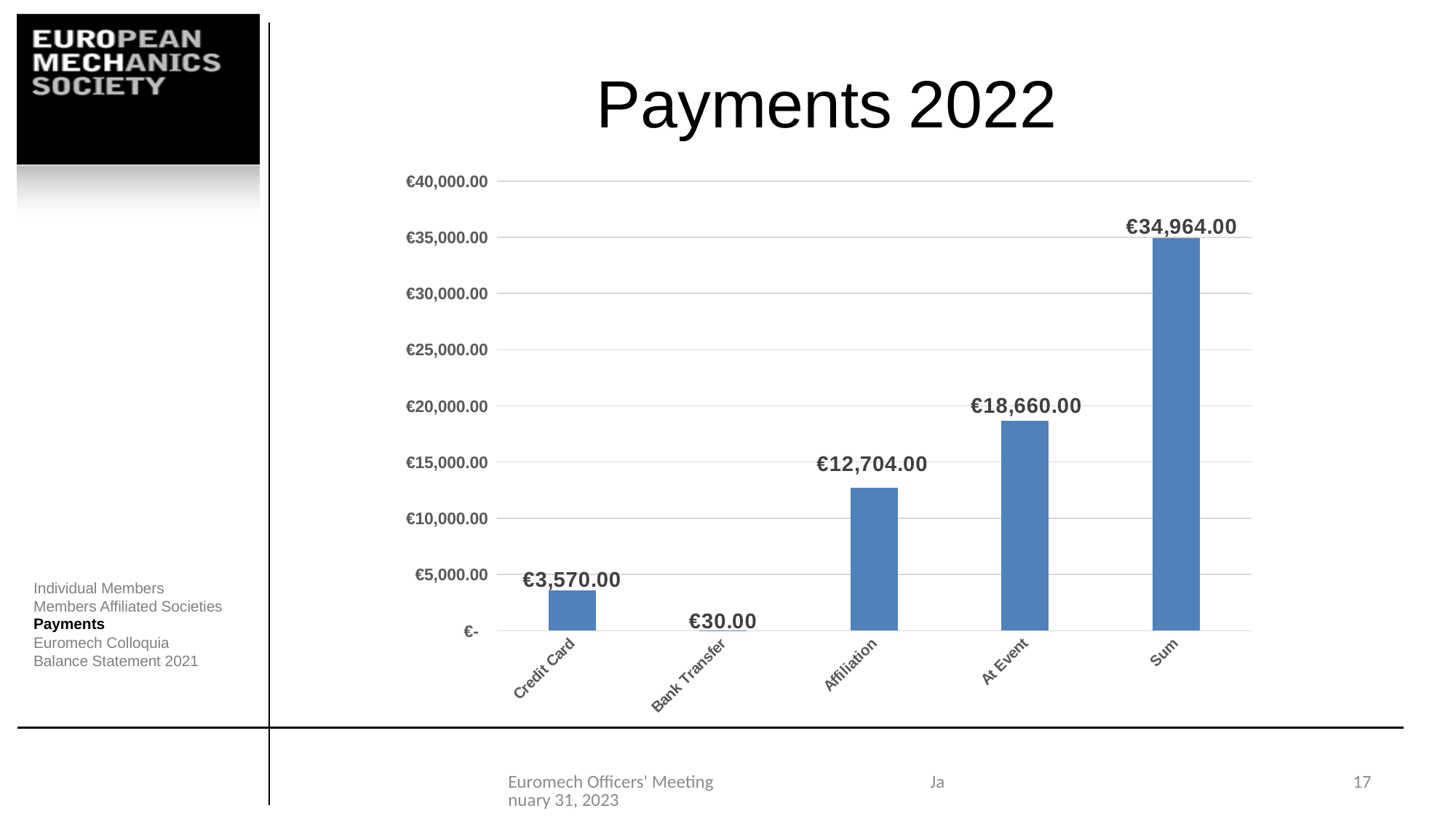
What is the value for Credit Card? €3,570.00 Which category has the highest value? Sum How many categories are shown on the x axis? 5 What is the title of the chart? Payments 2022 What is the difference between the values for At Event and Affiliation? €5,956.00 What kind of chart is shown on the slide? Bar chart Which is larger, the value for Credit Card or the value for Affiliation? Affiliation What is the value for Sum? €34,964.00 Which category has the lowest value? Bank Transfer What is the value for Affiliation? €12,704.00 What is the value for At Event? €18,660.00 What is the value for Bank Transfer? €30.00